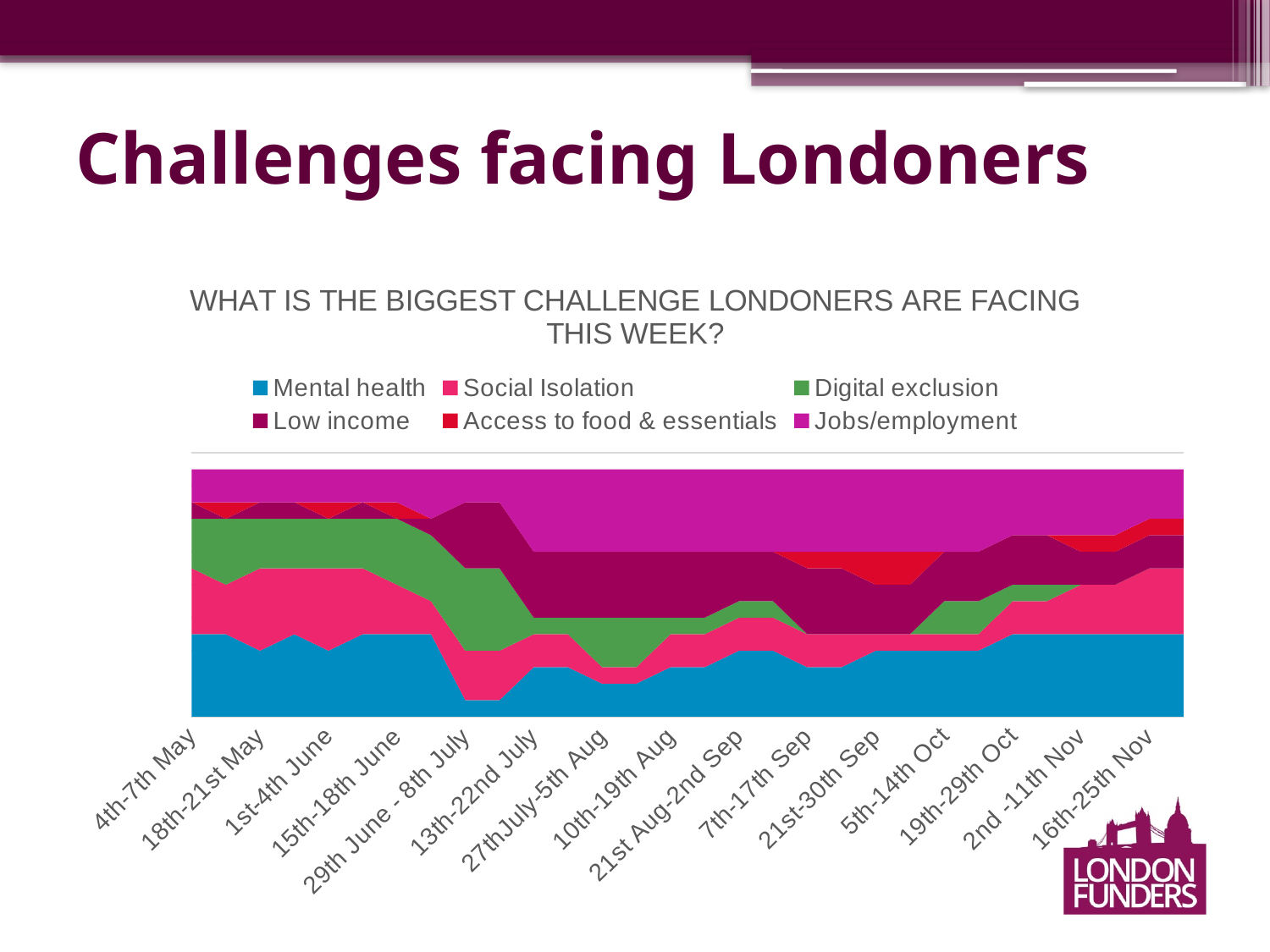
What is the first time period on the x axis? 4th-7th May Which series is shown in blue in the legend? Mental health What is the title of the chart? WHAT IS THE BIGGEST CHALLENGE LONDONERS ARE FACING THIS WEEK? What kind of chart is shown on the slide? Stacked area chart How many series does the legend list? 6 What is the last time period on the x axis? 16th-25th Nov